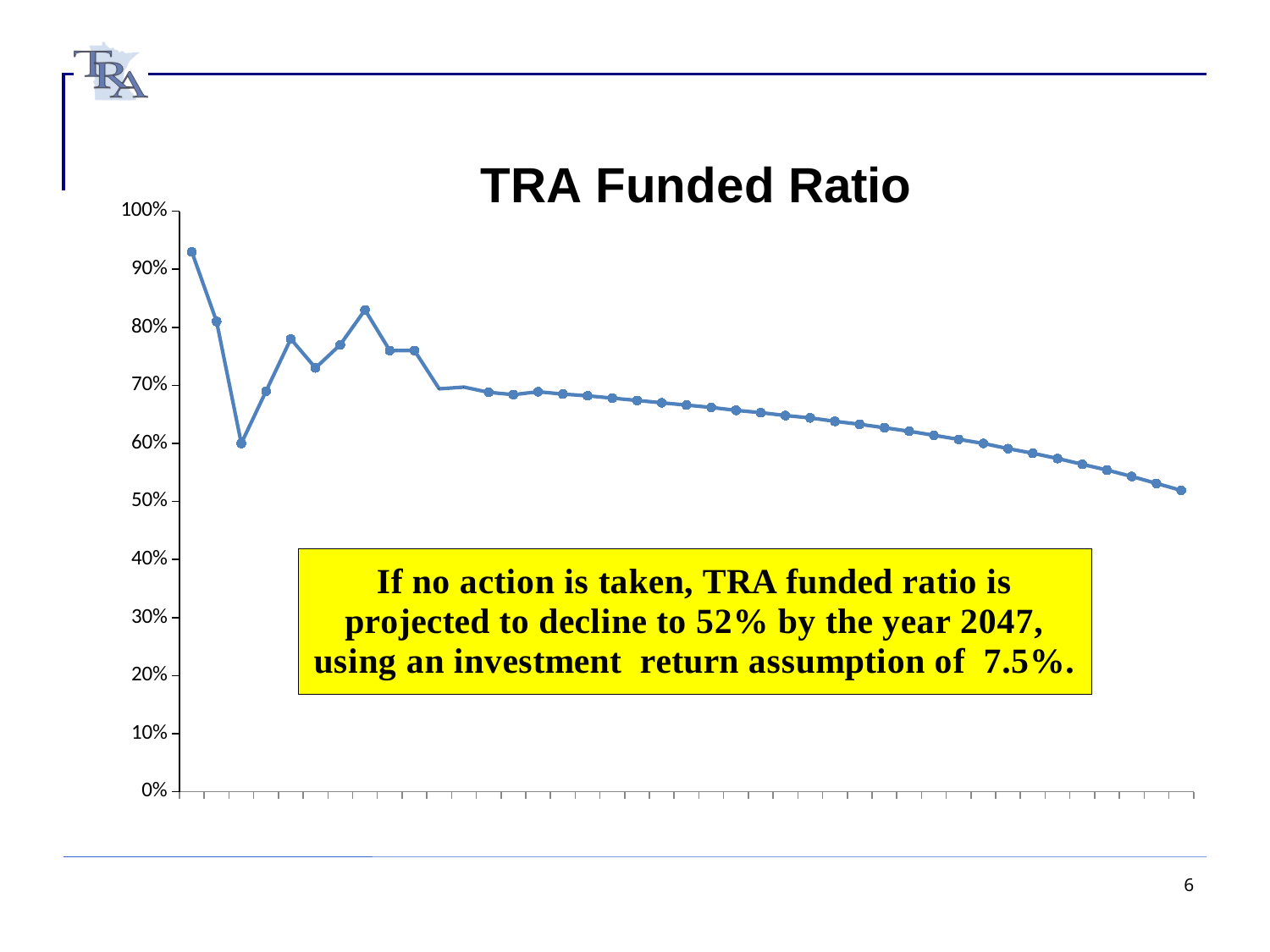
Is the lowest point on the line greater or less than 70%? less Does the lowest point on the line occur near the left, the middle, or the right of the chart? near the left Which is larger, the first point on the line or the last point on the line? the first point Is the last (rightmost) value on the line greater or less than 60%? less What is the title of the chart? TRA Funded Ratio Is the first (leftmost) value on the line greater or less than 90%? greater Overall, does the funded ratio rise or fall from left to right along the x axis? fall According to the slide, what funded ratio is TRA projected to decline to by the year 2047? 52% How many lines (series) are plotted on the chart? 1 What is the highest value shown on the y axis? 100% What kind of chart is shown on the slide? line chart